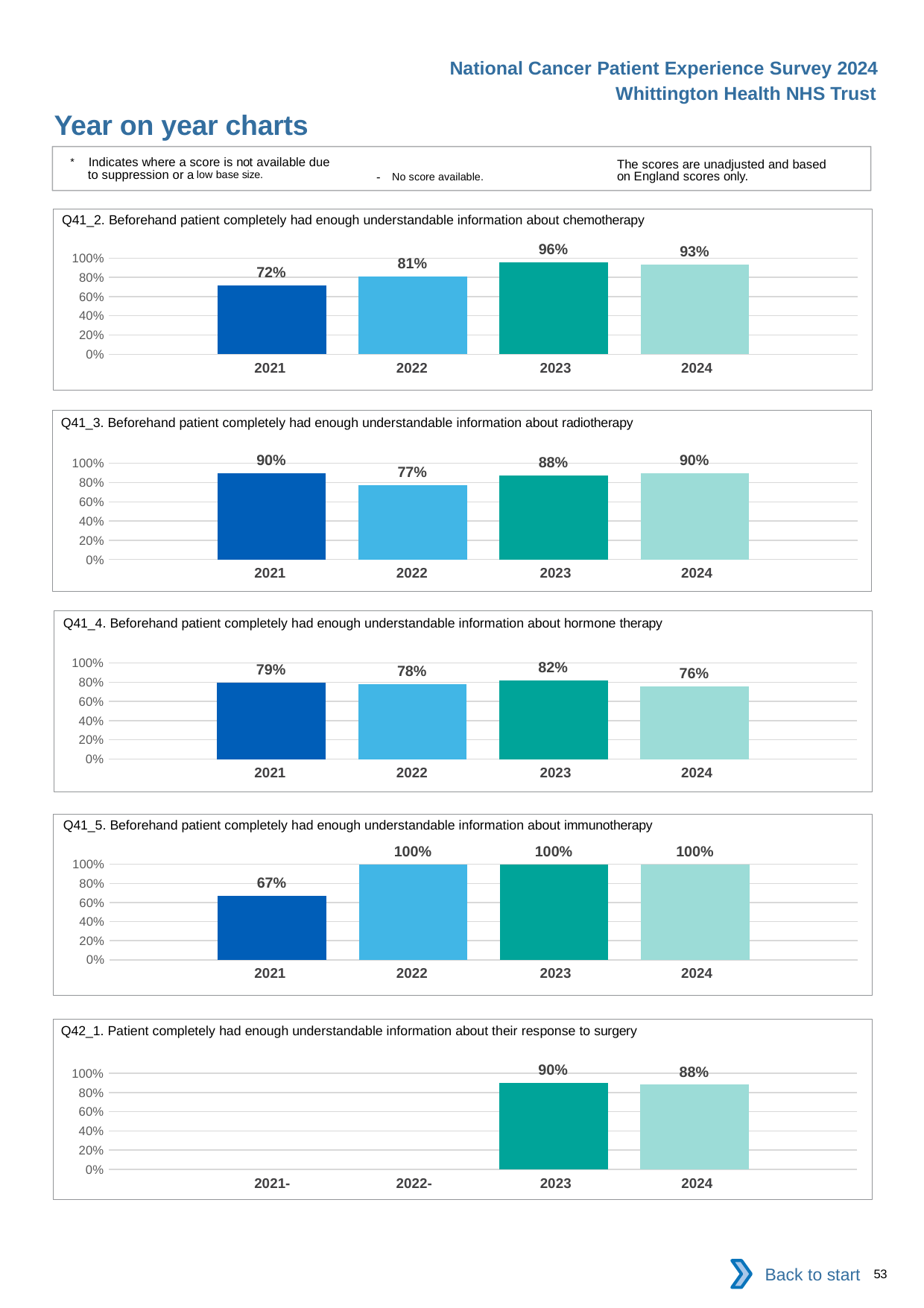
In the Q41_5 chart (immunotherapy), how many years show a value of 100%? 3 In the Q41_4 chart (hormone therapy), what is the value for 2024? 76% In the Q41_2 chart (chemotherapy), which year has the highest value? 2023 In the Q41_2 chart (chemotherapy), what is the value for 2021? 72% In the Q41_3 chart (radiotherapy), what is the difference between the 2023 and 2022 values? 11% What kind of chart is the Q41_2 chart (chemotherapy)? Bar chart In the Q42_1 chart (response to surgery), how many years have a bar plotted? 2 How many charts are shown on the slide? 5 In the Q41_4 chart (hormone therapy), which is larger, the value for 2023 or the value for 2024? 2023 In the Q42_1 chart (response to surgery), what is the difference between the 2023 and 2024 values? 2% In the Q41_5 chart (immunotherapy), what is the value for 2021? 67% In the Q41_3 chart (radiotherapy), which year has the lowest value? 2022